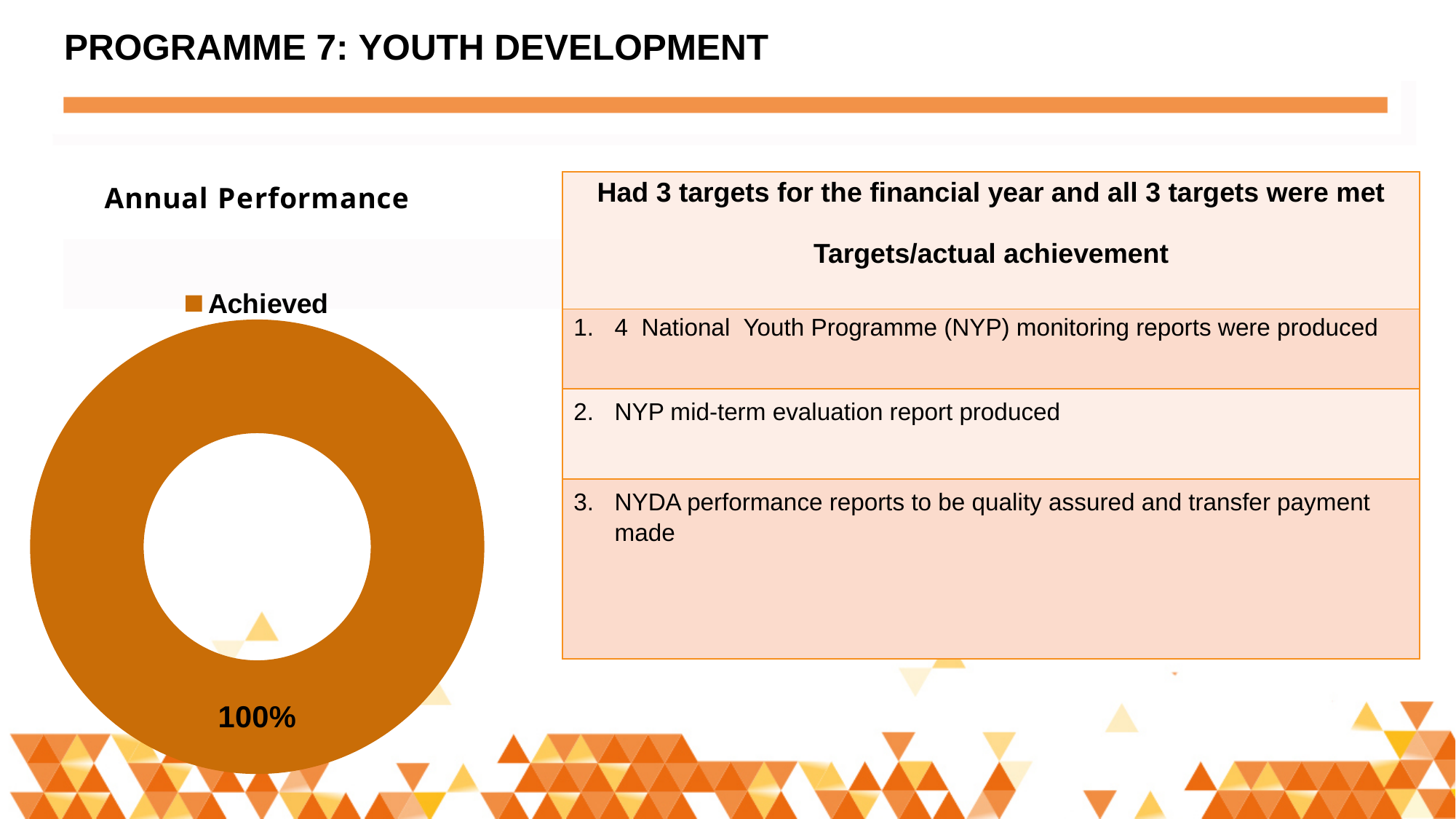
What kind of chart is shown under the title "Annual Performance"? Doughnut chart How many entries does the legend of the Annual Performance chart list? 1 How many slices does the Annual Performance chart have? 1 Is the value for "Achieved" in the Annual Performance chart greater or less than 50%? greater What share of the Annual Performance chart does the "Achieved" slice take up? 100% What is the title of the chart on the slide? Annual Performance What is the only legend entry in the Annual Performance chart? Achieved What value is shown for the "Achieved" slice in the Annual Performance chart? 100%